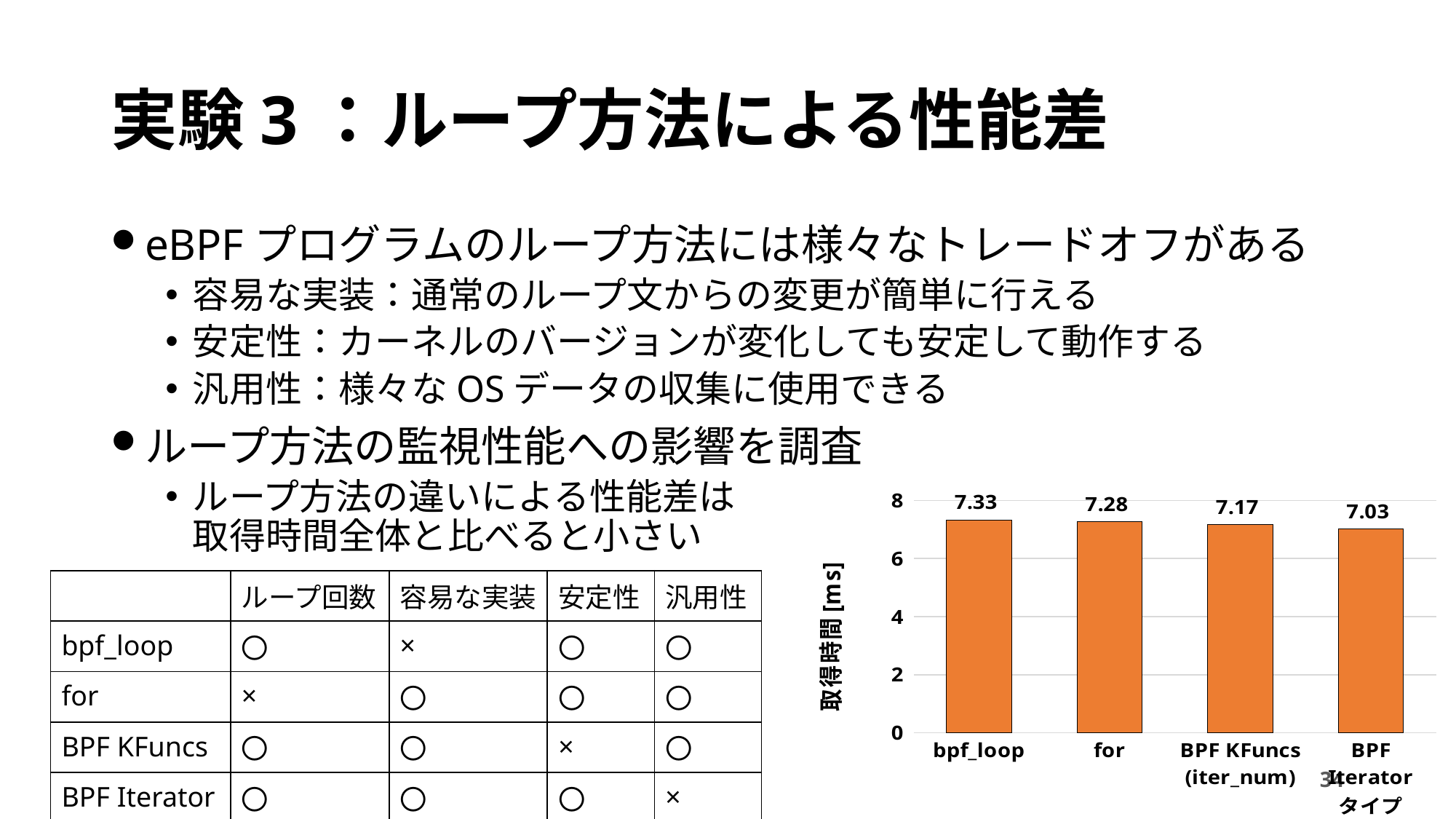
What is the label of the y axis of the bar chart? 取得時間 [ms] Which loop method has the highest value in the bar chart? bpf_loop What kind of chart is shown on the slide? bar chart What is the value for bpf_loop in the bar chart? 7.33 What is the value for the for loop method in the bar chart? 7.28 How many loop methods are plotted in the bar chart? 4 Which loop method has the lowest value in the bar chart? BPF Iterator タイプ What is the value for BPF Iterator タイプ in the bar chart? 7.03 What is the difference between the values for for and BPF KFuncs (iter_num)? 0.11 Which is larger, the value for bpf_loop or the value for BPF KFuncs (iter_num)? bpf_loop What is the difference between the values for bpf_loop and BPF Iterator タイプ? 0.30 What is the value for BPF KFuncs (iter_num) in the bar chart? 7.17